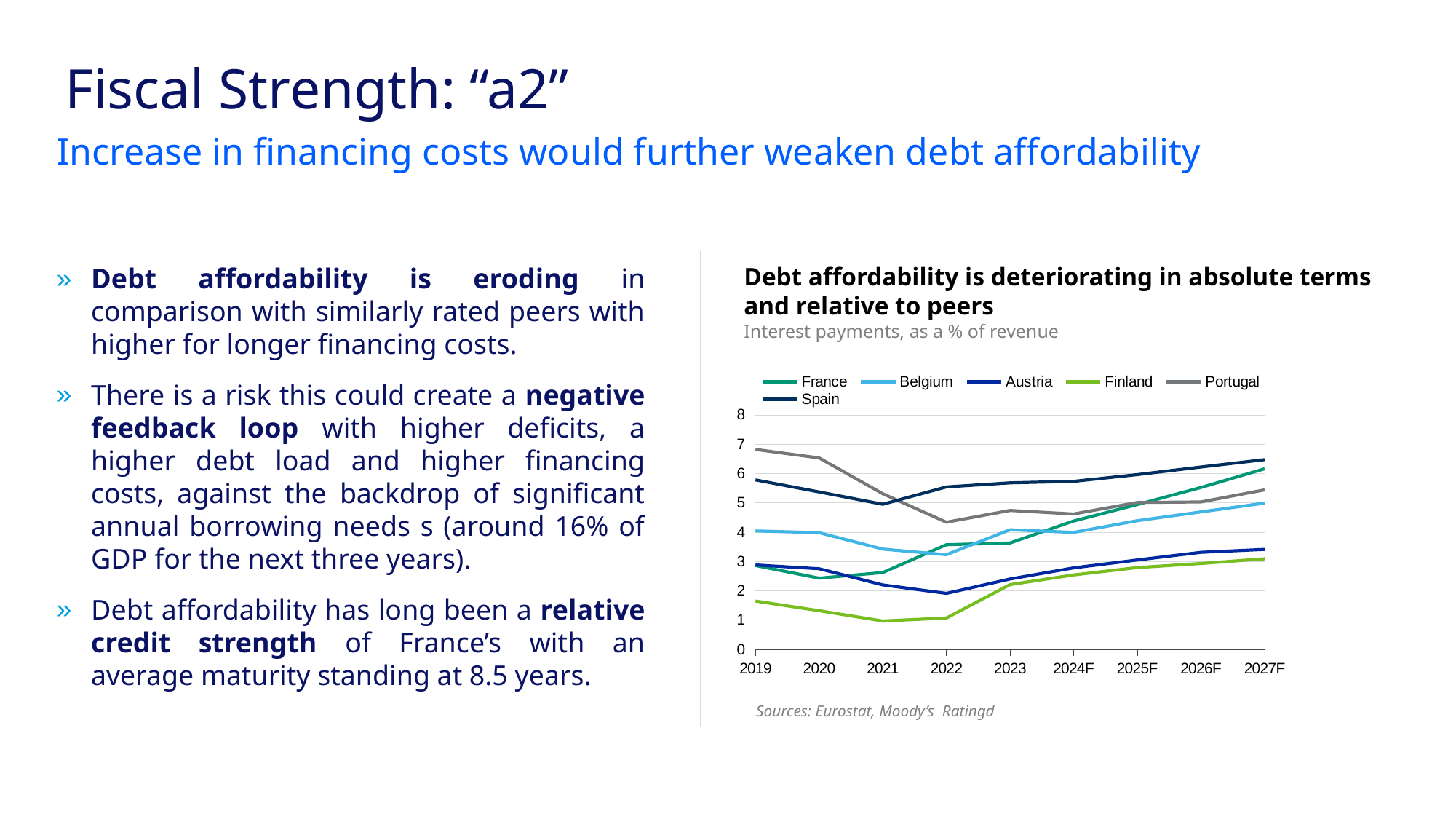
Is the value for Portugal in 2019 greater or less than 6? greater What type of chart is shown on the slide? Line chart Is the value for Finland in 2021 greater or less than 2? less Which country has the lowest interest payments as a % of revenue in 2019? Finland Does the Portugal line rise or fall between 2019 and 2022? Falls How many series does the legend of the chart list? 6 Which country has the highest interest payments as a % of revenue in 2019? Portugal In 2027F, which is larger: the value for France or the value for Belgium? France What measure does the chart plot, according to its subtitle? Interest payments, as a % of revenue How many years are shown along the x axis of the chart? 9 Is the value for France in 2027F greater or less than 5? greater Does the France line rise or fall between 2020 and 2027F? Rises